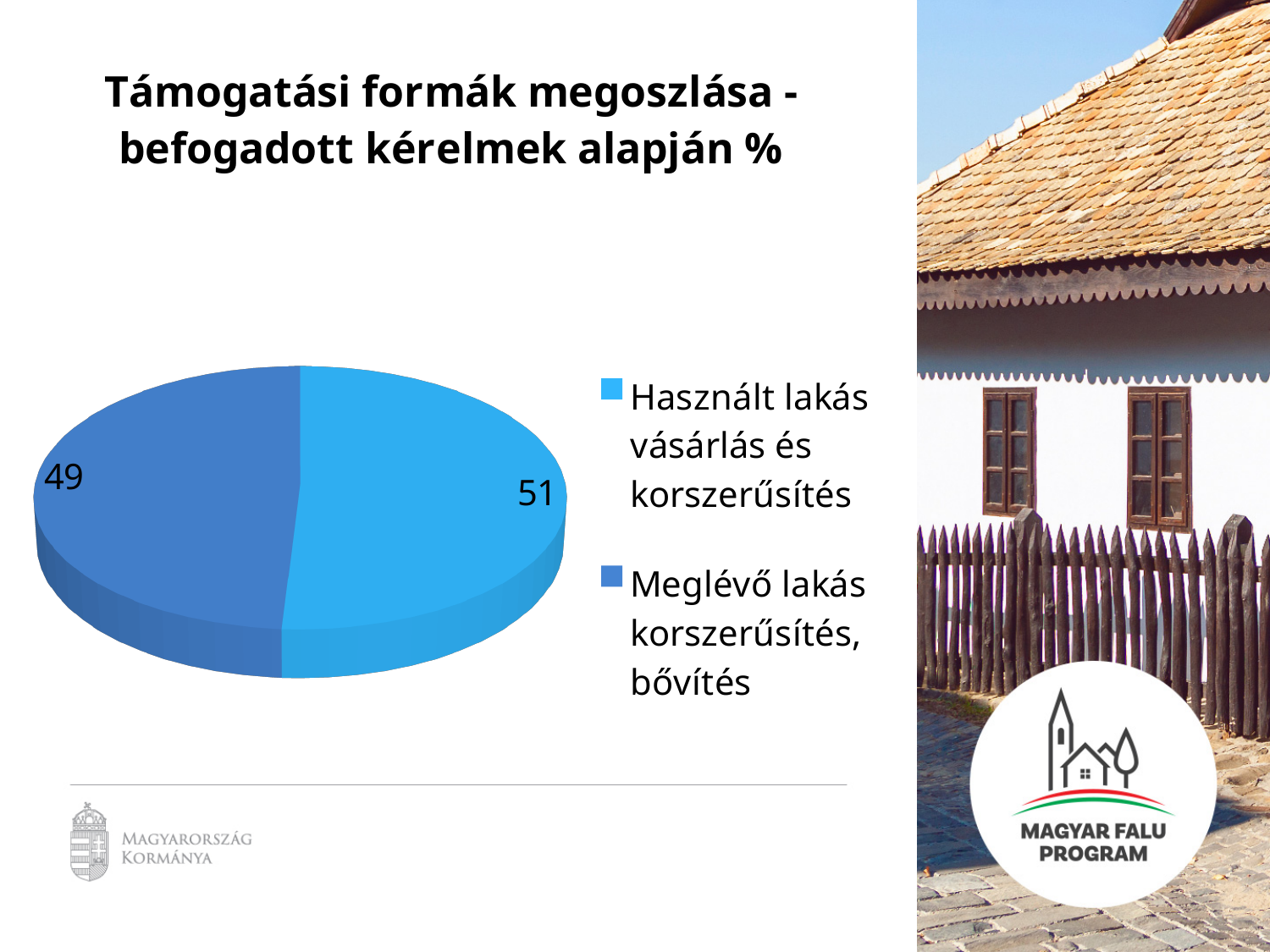
How many slices does the pie chart have? 2 How many entries does the legend list? 2 What is the total of the two values shown on the pie chart? 100 What is the title of the chart? Támogatási formák megoszlása - befogadott kérelmek alapján % Which category has the smallest slice of the pie? Meglévő lakás korszerűsítés, bővítés What is the difference between the values for "Használt lakás vásárlás és korszerűsítés" and "Meglévő lakás korszerűsítés, bővítés"? 2 What is the value for "Használt lakás vásárlás és korszerűsítés"? 51 Which category has the largest slice of the pie? Használt lakás vásárlás és korszerűsítés What kind of chart is shown on the slide? pie chart Which legend entry is shown in the lighter blue colour? Használt lakás vásárlás és korszerűsítés Which is larger: "Használt lakás vásárlás és korszerűsítés" or "Meglévő lakás korszerűsítés, bővítés"? Használt lakás vásárlás és korszerűsítés What is the value for "Meglévő lakás korszerűsítés, bővítés"? 49